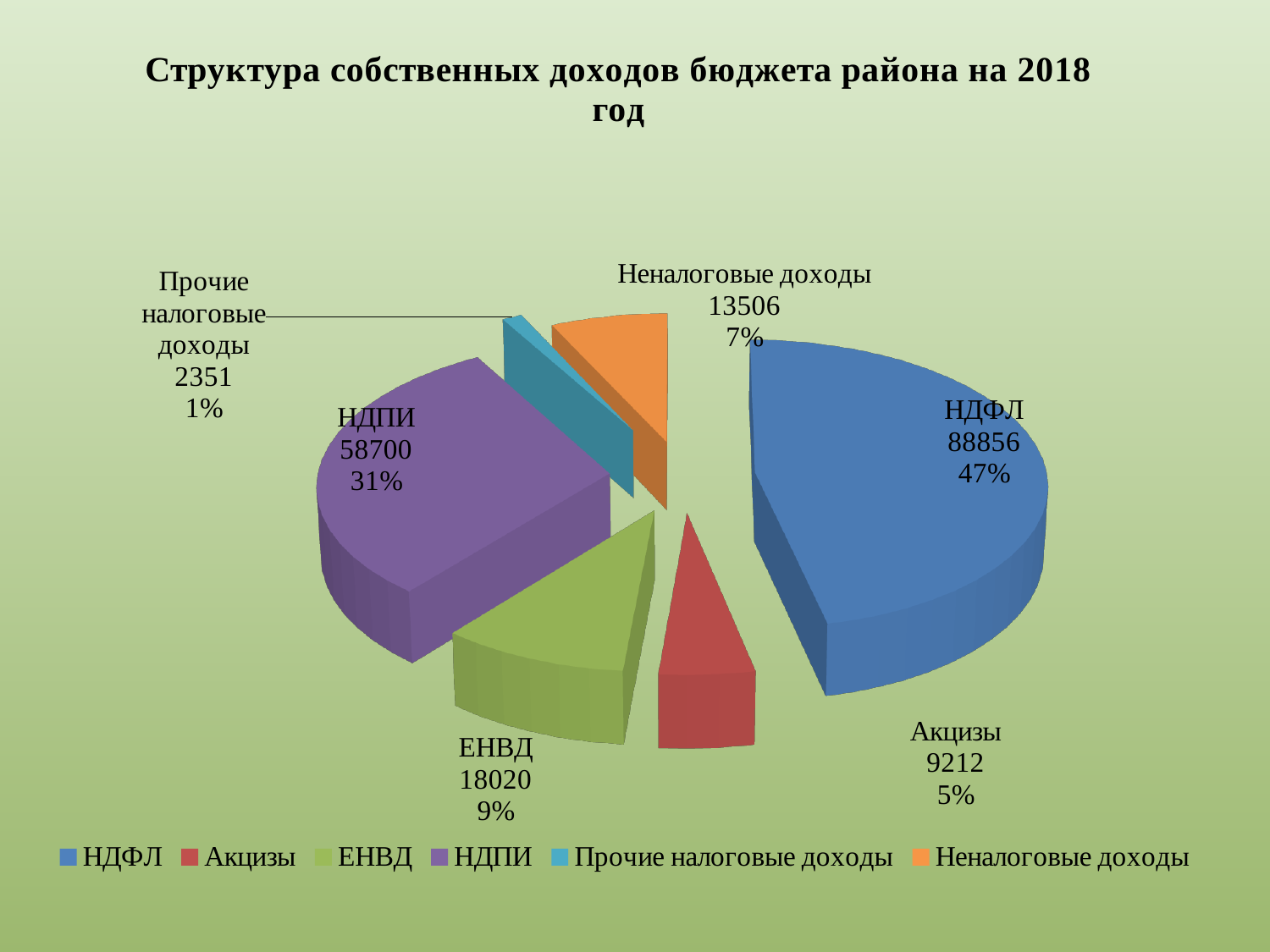
What share of the pie does Акцизы represent? 5% Which is larger, the value for ЕНВД or the value for Акцизы? ЕНВД What is the title of the chart? Структура собственных доходов бюджета района на 2018 год What is the value for НДФЛ? 88856 What kind of chart is shown on the slide? Pie chart Which category has the smallest slice? Прочие налоговые доходы How many categories does the pie chart have? 6 What is the difference between the values for НДФЛ and НДПИ? 30156 What share of the pie does ЕНВД represent? 9% Which category has the largest slice? НДФЛ What is the value for Неналоговые доходы? 13506 What is the value for НДПИ? 58700